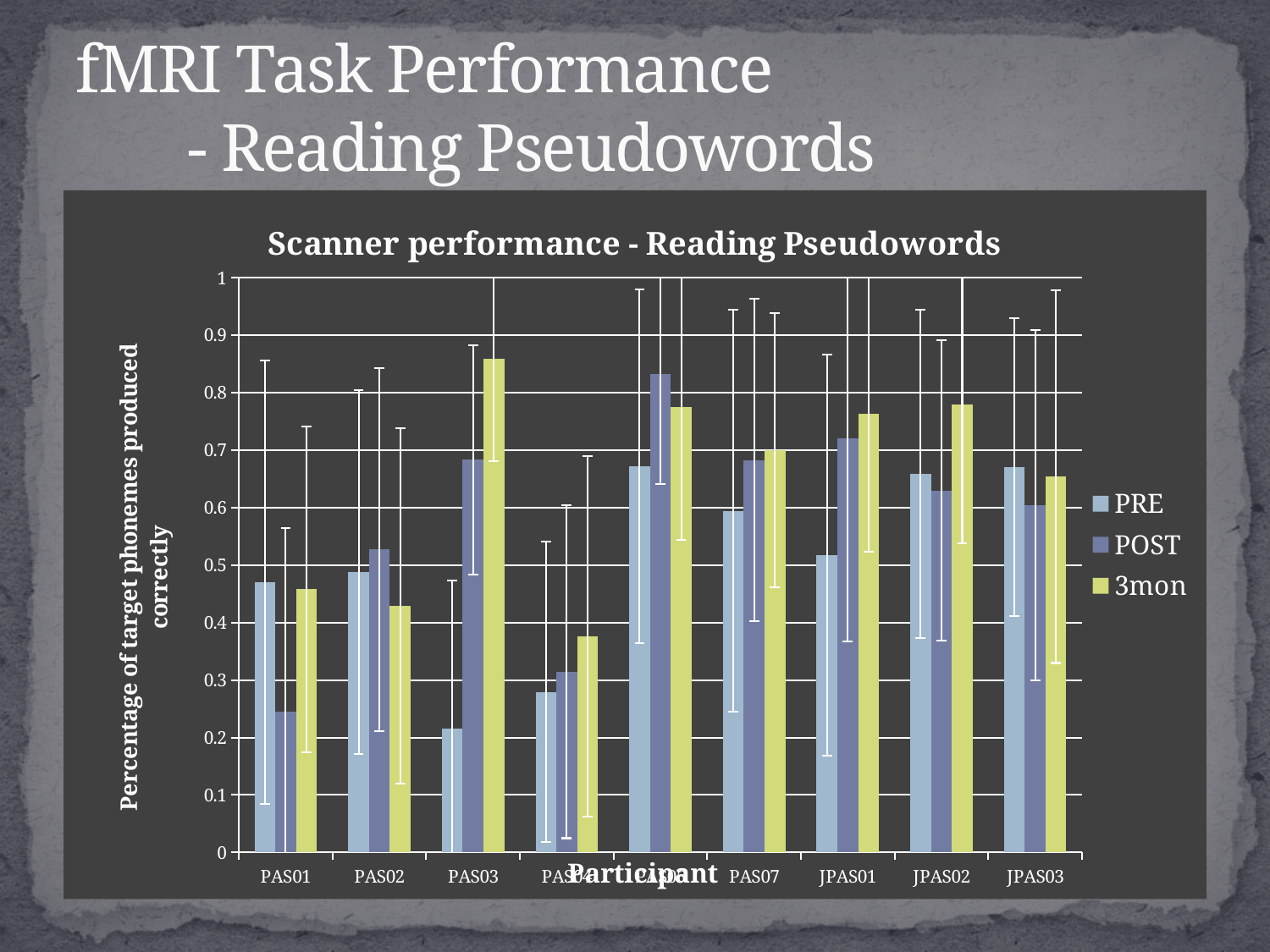
Is the 3mon value for PAS03 greater or less than 0.8? greater For JPAS01, which is larger, the PRE value or the POST value? POST How many series does the legend list? 3 Is the PRE value for PAS03 greater or less than 0.3? less Is the 3mon value for JPAS02 greater or less than 0.7? greater What kind of chart is shown on the slide? bar chart What is the title of the chart? Scanner performance - Reading Pseudowords Which participant has the lowest PRE value? PAS03 For PAS01, which is larger, the PRE value or the POST value? PRE Which participant has the highest 3mon value? PAS03 How many participants are shown along the x axis? 9